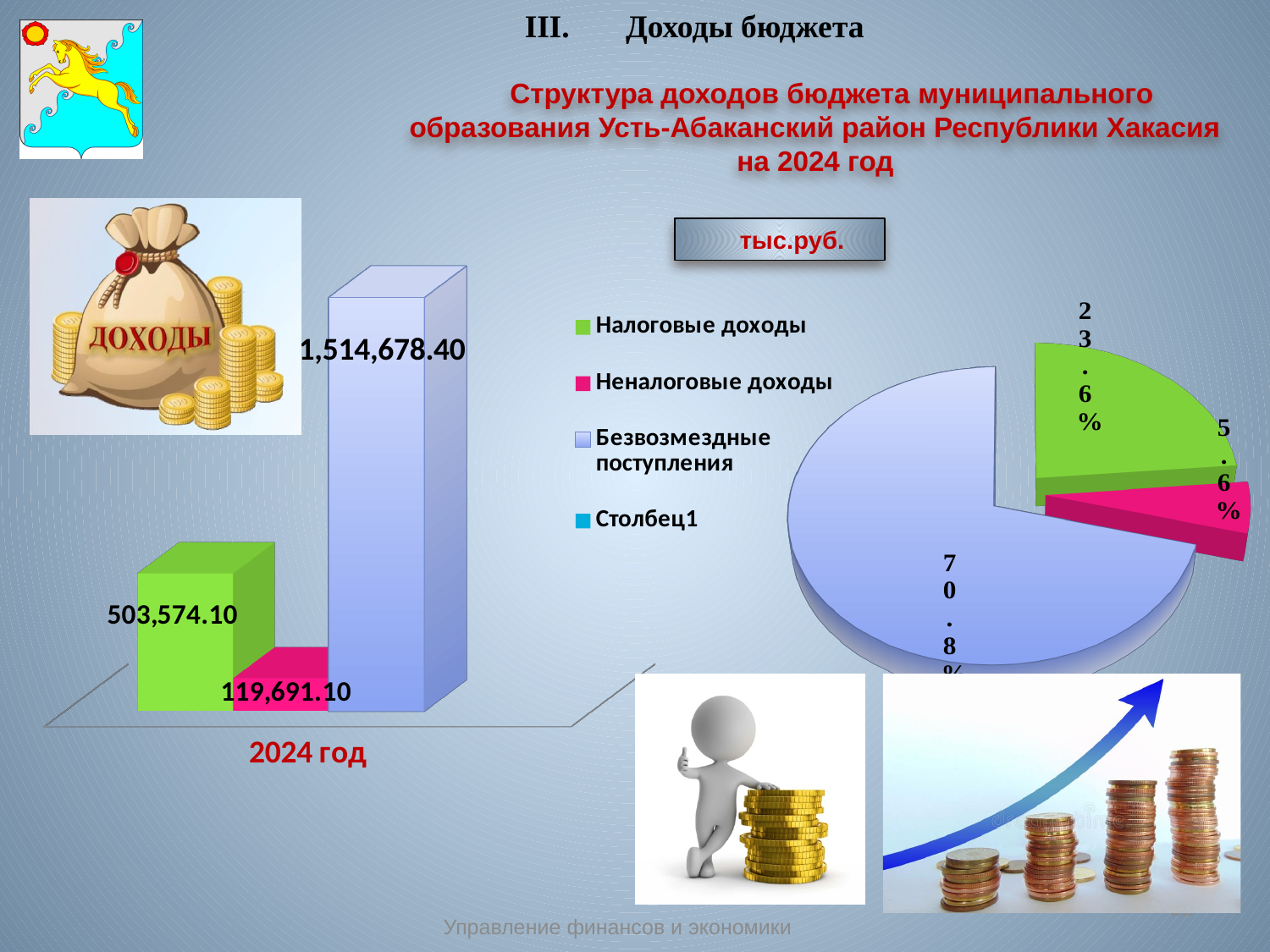
What kind of chart is shown on the left side of the slide? Bar chart In the bar chart, what is the difference between Безвозмездные поступления and Налоговые доходы? 1,011,104.30 How many entries does the legend of the bar chart list? 4 In the bar chart, what is the difference between Налоговые доходы and Неналоговые доходы? 383,883.00 In the bar chart, which income category has the highest value? Безвозмездные поступления In the pie chart, what share does Налоговые доходы have? 23.6% In the bar chart, which income category has the lowest value? Неналоговые доходы In the pie chart, what share does Неналоговые доходы have? 5.6% In the bar chart, which is larger: Налоговые доходы or Неналоговые доходы? Налоговые доходы In the bar chart, what is the value for Налоговые доходы in 2024 год? 503,574.10 In the bar chart, what is the value for Неналоговые доходы in 2024 год? 119,691.10 In the bar chart, what is the value for Безвозмездные поступления in 2024 год? 1,514,678.40